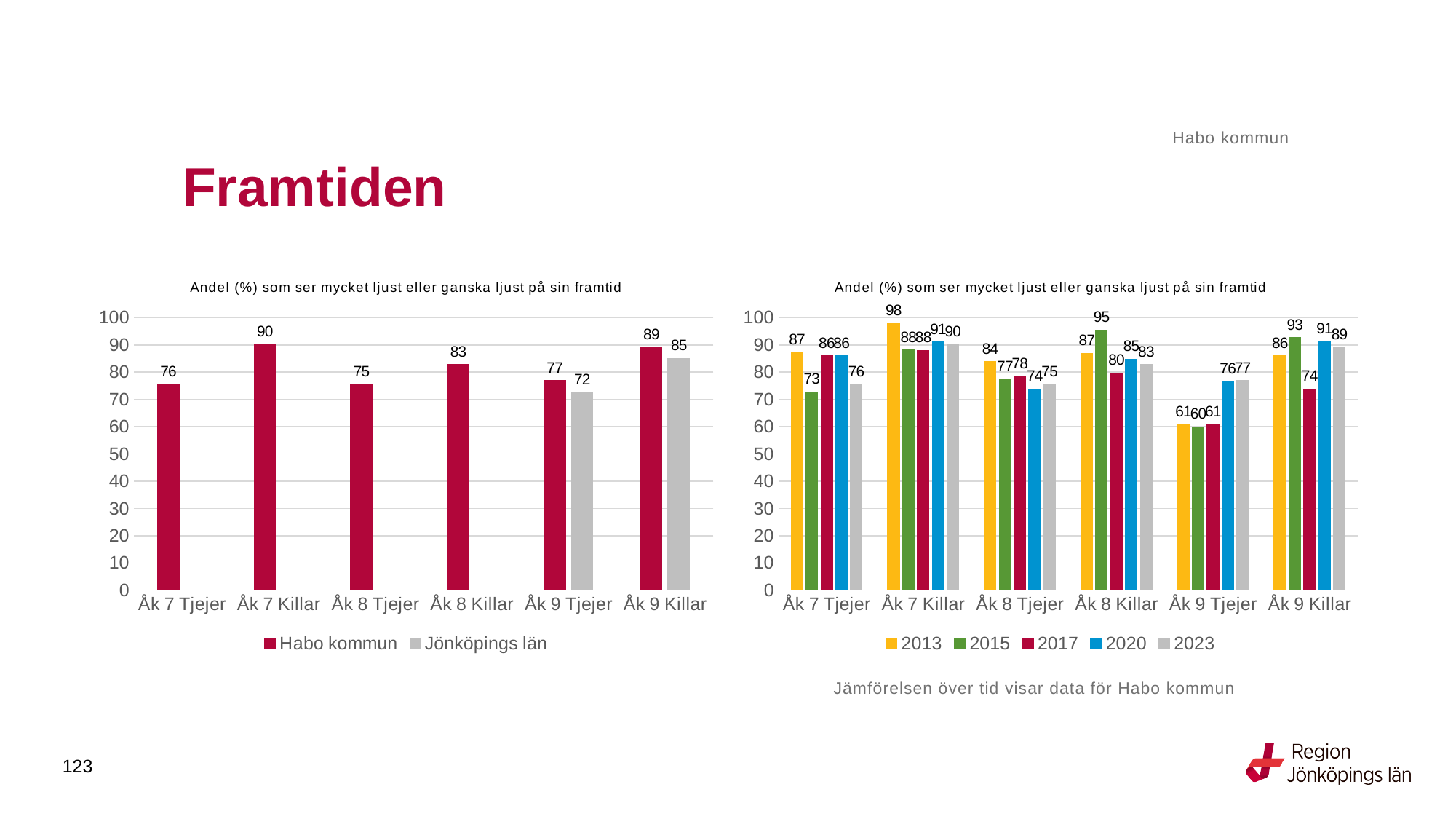
In the right chart, which year has the lowest value for Åk 9 Killar? 2017 In the right chart, what is the difference between the 2023 and 2013 values for Åk 9 Tjejer? 16 In the left chart, what is the value for Habo kommun for Åk 7 Killar? 90 In the left chart, what is the value for Jönköpings län for Åk 9 Tjejer? 72 In the left chart, how many series does the legend list? 2 In the right chart, what is the value for 2015 for Åk 8 Killar? 95 In the left chart, what is the difference between Habo kommun and Jönköpings län for Åk 9 Killar? 4 What type of chart is the right chart? Bar chart In the right chart, how many series does the legend list? 5 In the right chart, what is the value for 2013 for Åk 7 Killar? 98 In the left chart, which category has the lowest Habo kommun value? Åk 8 Tjejer In the left chart, is the Habo kommun value for Åk 8 Killar greater or less than 80? greater